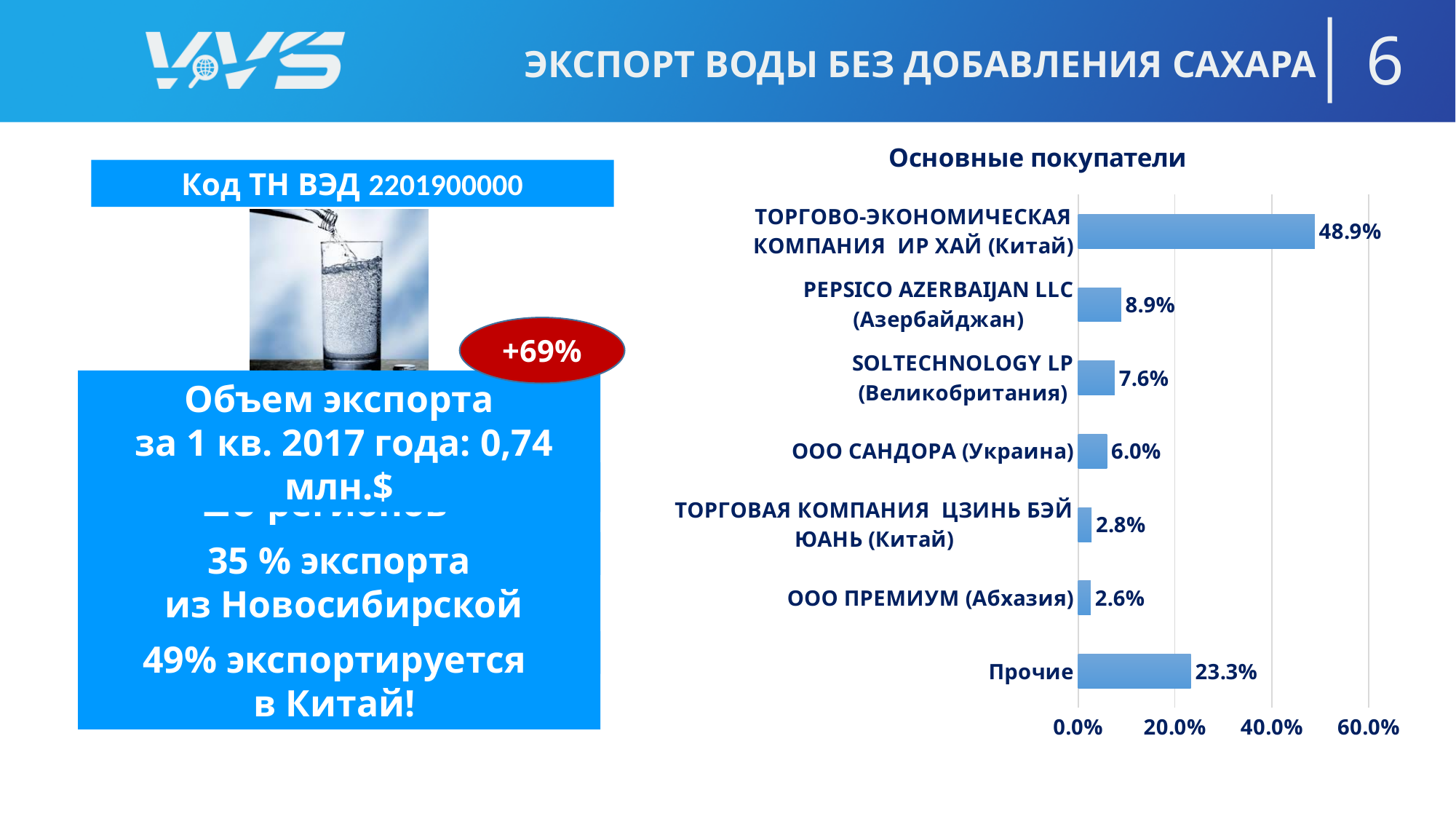
What is the value for ТОРГОВО-ЭКОНОМИЧЕСКАЯ КОМПАНИЯ ИР ХАЙ (Китай) in the chart? 48.9% What is the value for Прочие? 23.3% What is the title of the chart? Основные покупатели Which category has the lowest value in the chart? ООО ПРЕМИУМ (Абхазия) How many categories are shown in the chart? 7 Is the value for Прочие greater or less than 20.0%? greater What is the value for ООО САНДОРА (Украина)? 6.0% What is the difference between the values for SOLTECHNOLOGY LP (Великобритания) and ООО САНДОРА (Украина)? 1.6% Which is larger: the value for PEPSICO AZERBAIJAN LLC (Азербайджан) or SOLTECHNOLOGY LP (Великобритания)? PEPSICO AZERBAIJAN LLC (Азербайджан) Which named buyer has the highest share in the chart? ТОРГОВО-ЭКОНОМИЧЕСКАЯ КОМПАНИЯ ИР ХАЙ (Китай) What kind of chart is shown on the slide? bar chart What is the value for PEPSICO AZERBAIJAN LLC (Азербайджан)? 8.9%